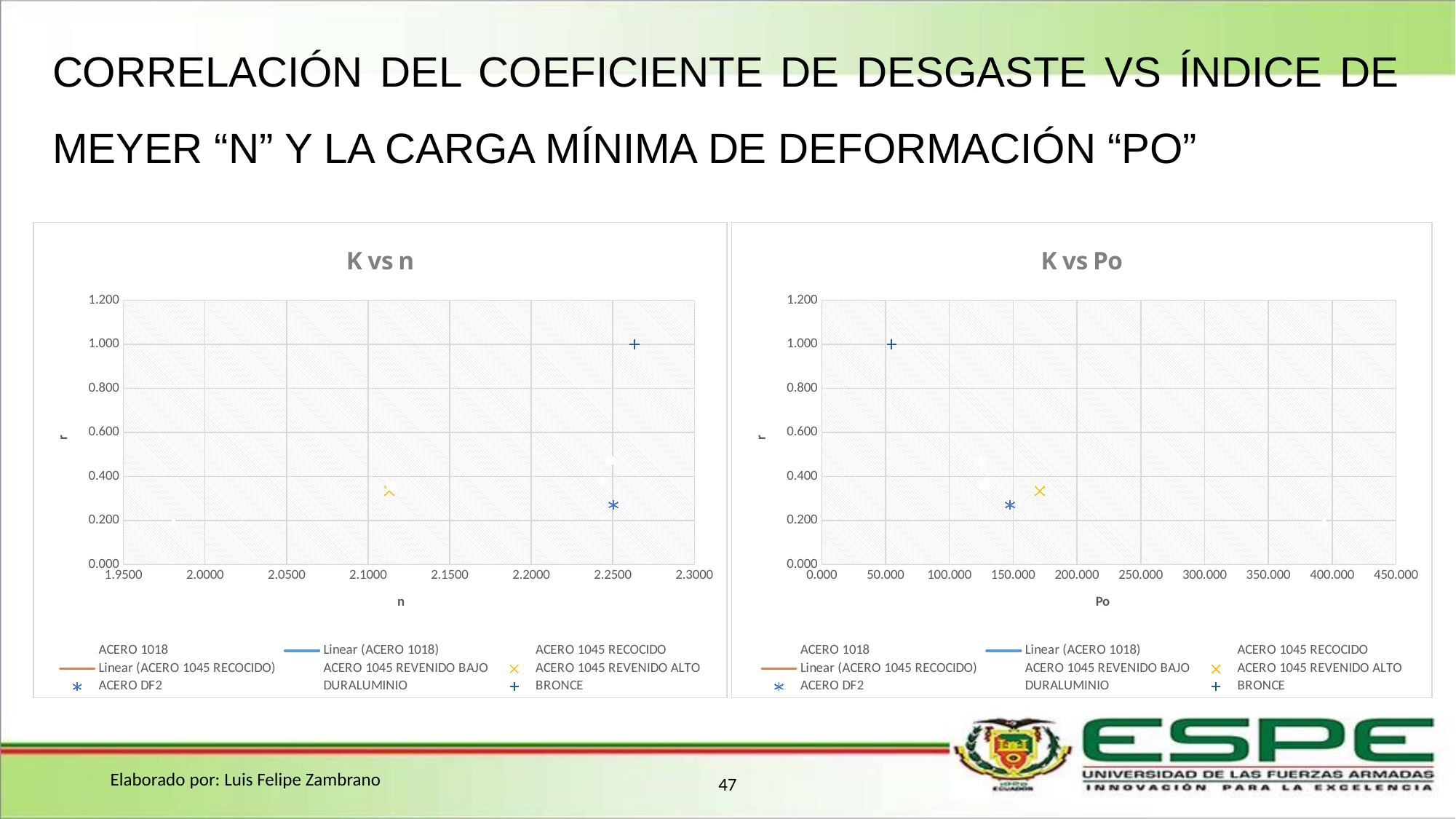
What kind of chart is the "K vs n" chart? scatter chart In the "K vs n" chart, is the r value for BRONCE greater or less than 0.800? greater In the "K vs Po" chart, is the Po value for ACERO 1045 REVENIDO ALTO greater or less than 150.000? greater What kind of chart is the "K vs Po" chart? scatter chart In the "K vs Po" chart, which visible series has the highest r value? BRONCE In the "K vs n" chart, which visible series has the highest r value? BRONCE What is the label of the horizontal axis of the "K vs Po" chart? Po In the "K vs n" chart, which has the larger r value, BRONCE or ACERO 1045 REVENIDO ALTO? BRONCE In the "K vs Po" chart, is the Po value for BRONCE greater or less than 100.000? less In the "K vs Po" chart, which has the larger Po value, ACERO DF2 or BRONCE? ACERO DF2 How many entries does the legend of the "K vs Po" chart list? 9